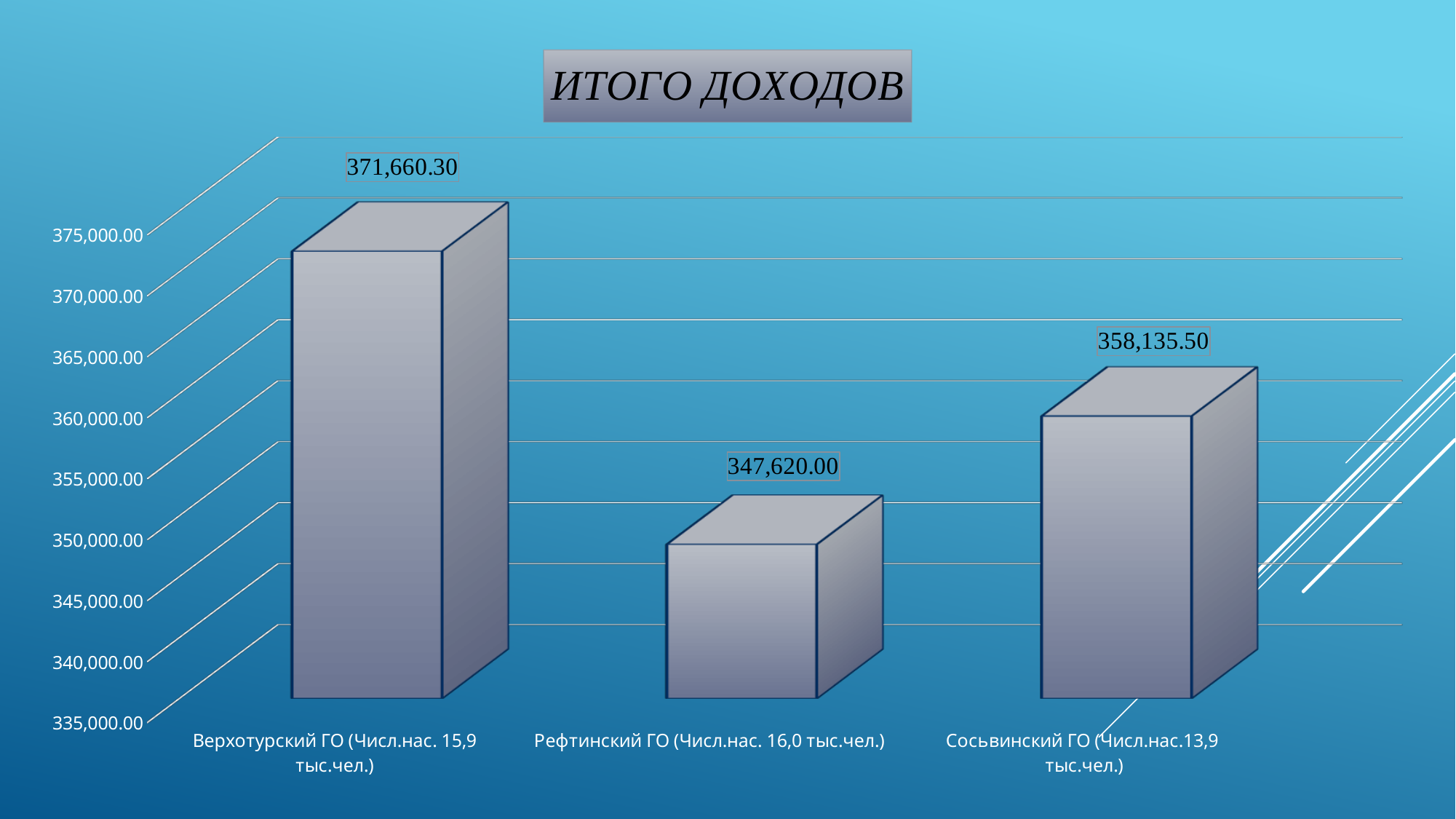
How many categories are shown in the chart? 3 Which category has the highest value? Верхотурский ГО Is the value for Рефтинский ГО greater or less than 350,000.00? less Which is larger, the value for Сосьвинский ГО or the value for Рефтинский ГО? Сосьвинский ГО What is the value for Сосьвинский ГО? 358,135.50 What is the title of the chart? ИТОГО ДОХОДОВ What is the value for Рефтинский ГО? 347,620.00 What is the value for Верхотурский ГО? 371,660.30 What is the difference between the values for Верхотурский ГО and Рефтинский ГО? 24,040.30 What is the difference between the values for Сосьвинский ГО and Рефтинский ГО? 10,515.50 Which category has the lowest value? Рефтинский ГО What kind of chart is shown on the slide? bar chart